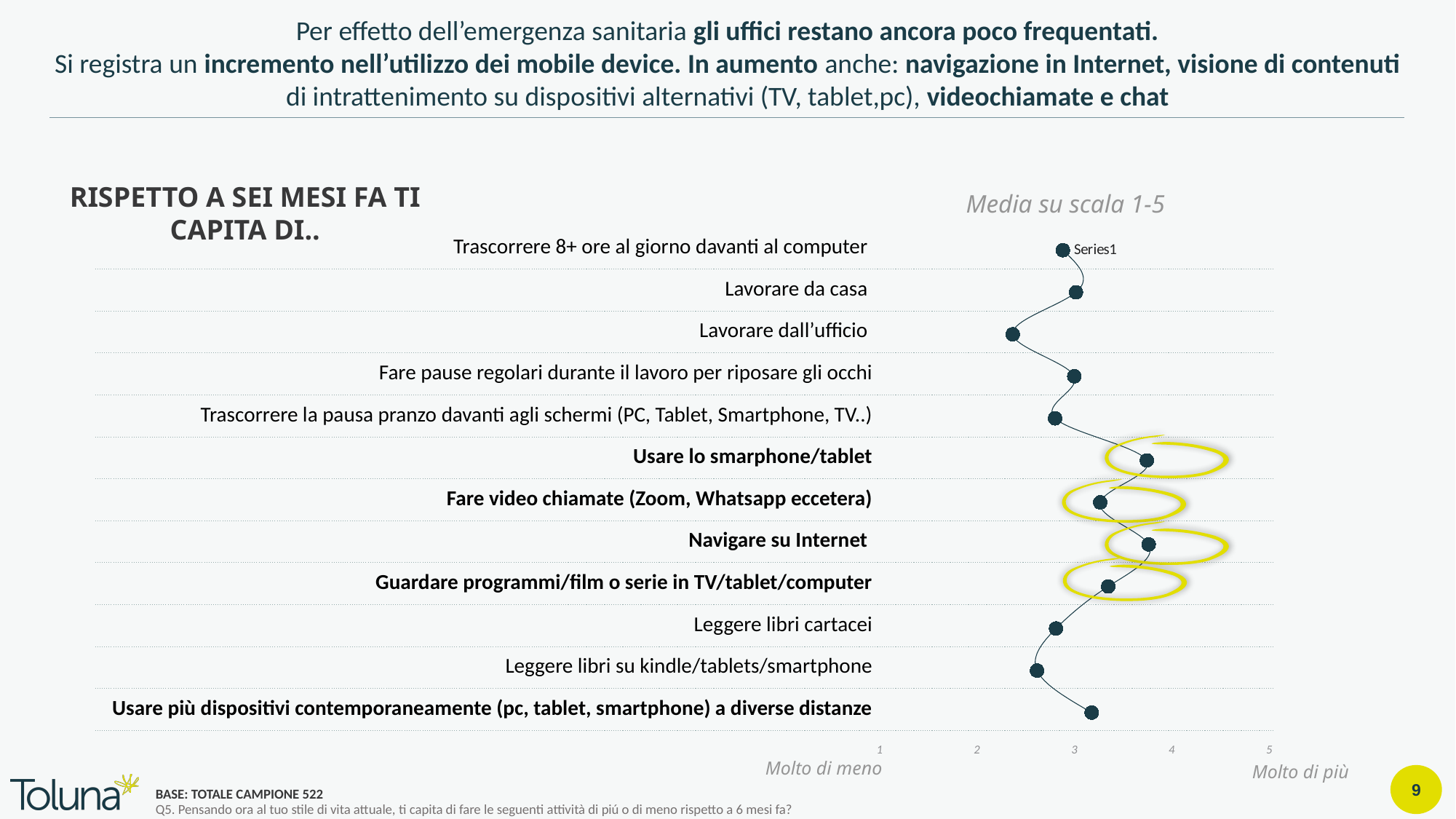
What kind of chart is shown on the slide? Line chart Which activity has the lowest value in the chart? Lavorare dall'ufficio Is the value for 'Leggere libri su kindle/tablets/smartphone' greater or less than 3? less Is the value for 'Usare lo smartphone/tablet' greater or less than 3? greater How many series does the chart legend list? 1 What is the name of the series shown in the chart legend? Series1 What label appears under the value 5 on the chart's axis? Molto di più Which has the larger value: 'Usare lo smartphone/tablet' or 'Fare video chiamate (Zoom, Whatsapp eccetera)'? Usare lo smartphone/tablet Which has the larger value: 'Lavorare da casa' or 'Lavorare dall'ufficio'? Lavorare da casa How many categories (activities) are plotted in the chart? 12 Is the value for 'Lavorare dall'ufficio' greater or less than 3? less